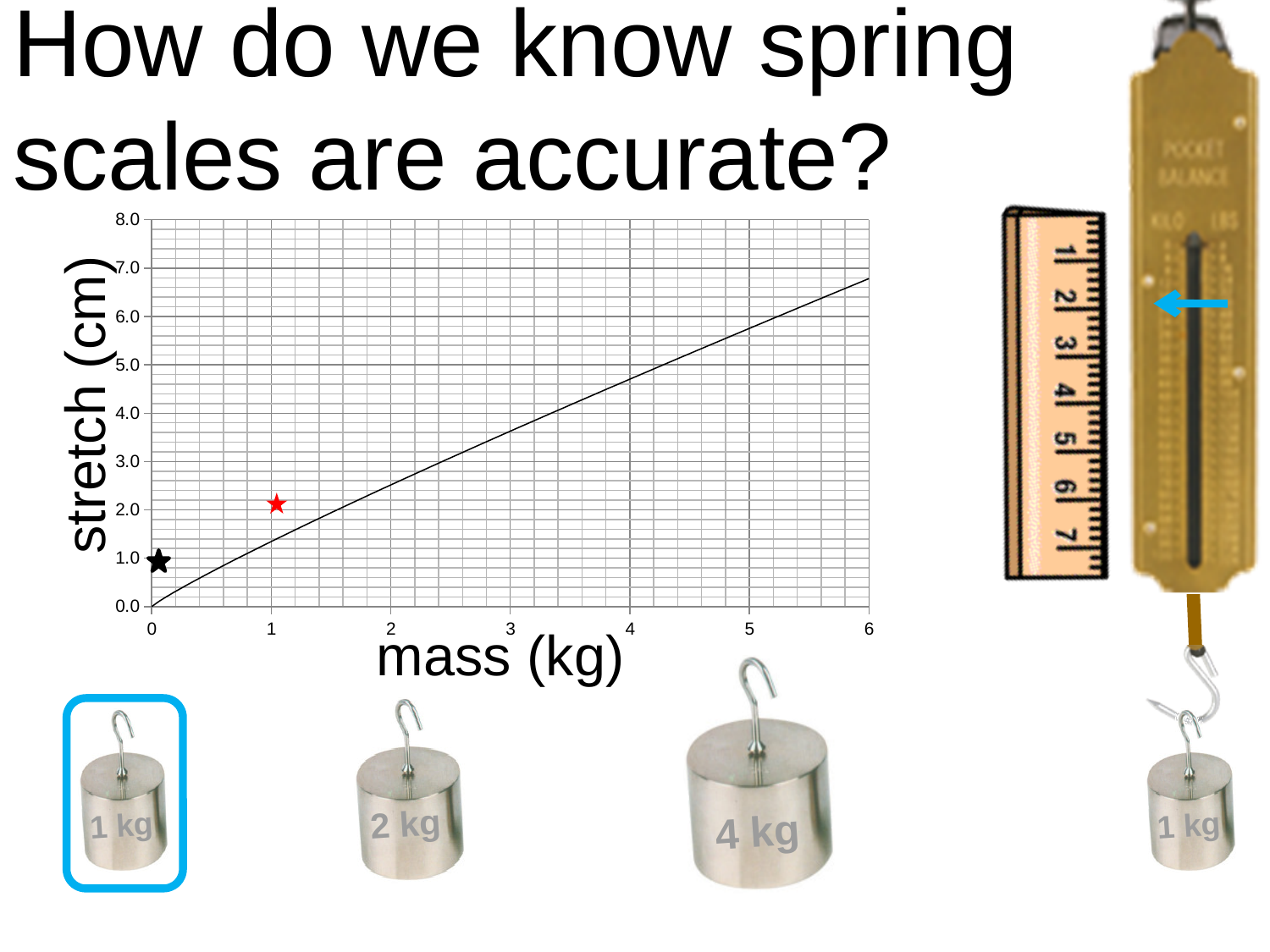
How many star markers are plotted on the chart? 2 Does the stretch rise or fall as mass increases along the x axis? rise Is the stretch marked by the black star greater or less than 2.0 cm? less Is the stretch on the line at a mass of 5 kg greater or less than 5.0 cm? greater What is the label of the x axis of the chart? mass (kg) Which star marker shows the larger stretch, the red star or the black star? red star Is the stretch on the line at a mass of 6 kg greater or less than 6.0 cm? greater What kind of chart is shown on the slide? line chart What is the label of the y axis of the chart? stretch (cm)